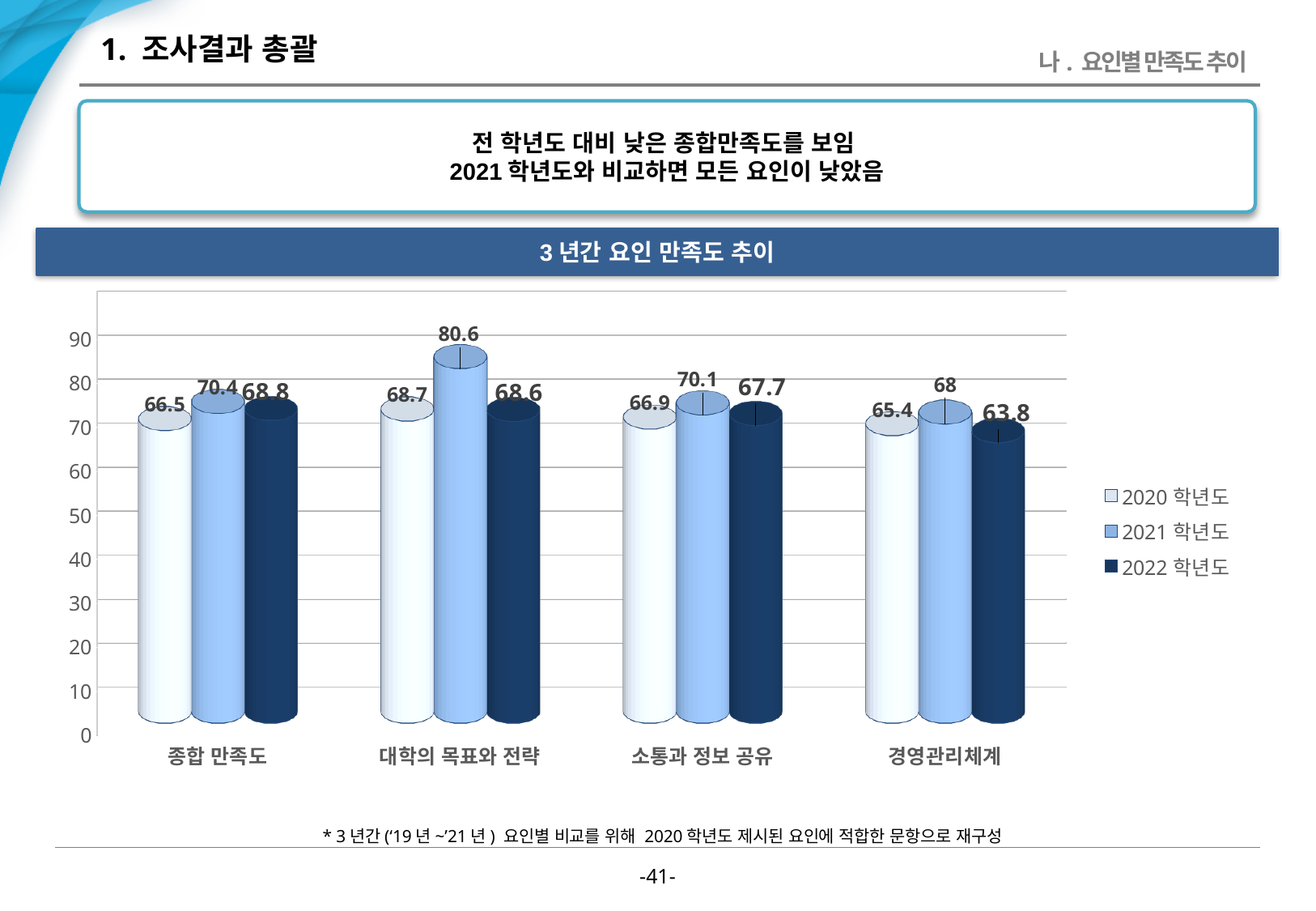
What is the value for 경영관리체계 in the 2022 학년도 series? 63.8 What is the title of the chart? 3 년간 요인 만족도 추이 Which category has the lowest value in the 2022 학년도 series? 경영관리체계 How many series does the legend list? 3 Which category has the highest value in the 2021 학년도 series? 대학의 목표와 전략 Which is larger for 경영관리체계: the 2020 학년도 value or the 2021 학년도 value? 2021 학년도 What is the value for 소통과 정보 공유 in the 2022 학년도 series? 67.7 What is the value for 대학의 목표와 전략 in the 2021 학년도 series? 80.6 How many categories are shown on the x axis? 4 What kind of chart is shown on the slide? bar chart What is the difference between the 2021 학년도 and 2022 학년도 values for 대학의 목표와 전략? 12 What is the value for 종합 만족도 in the 2020 학년도 series? 66.5